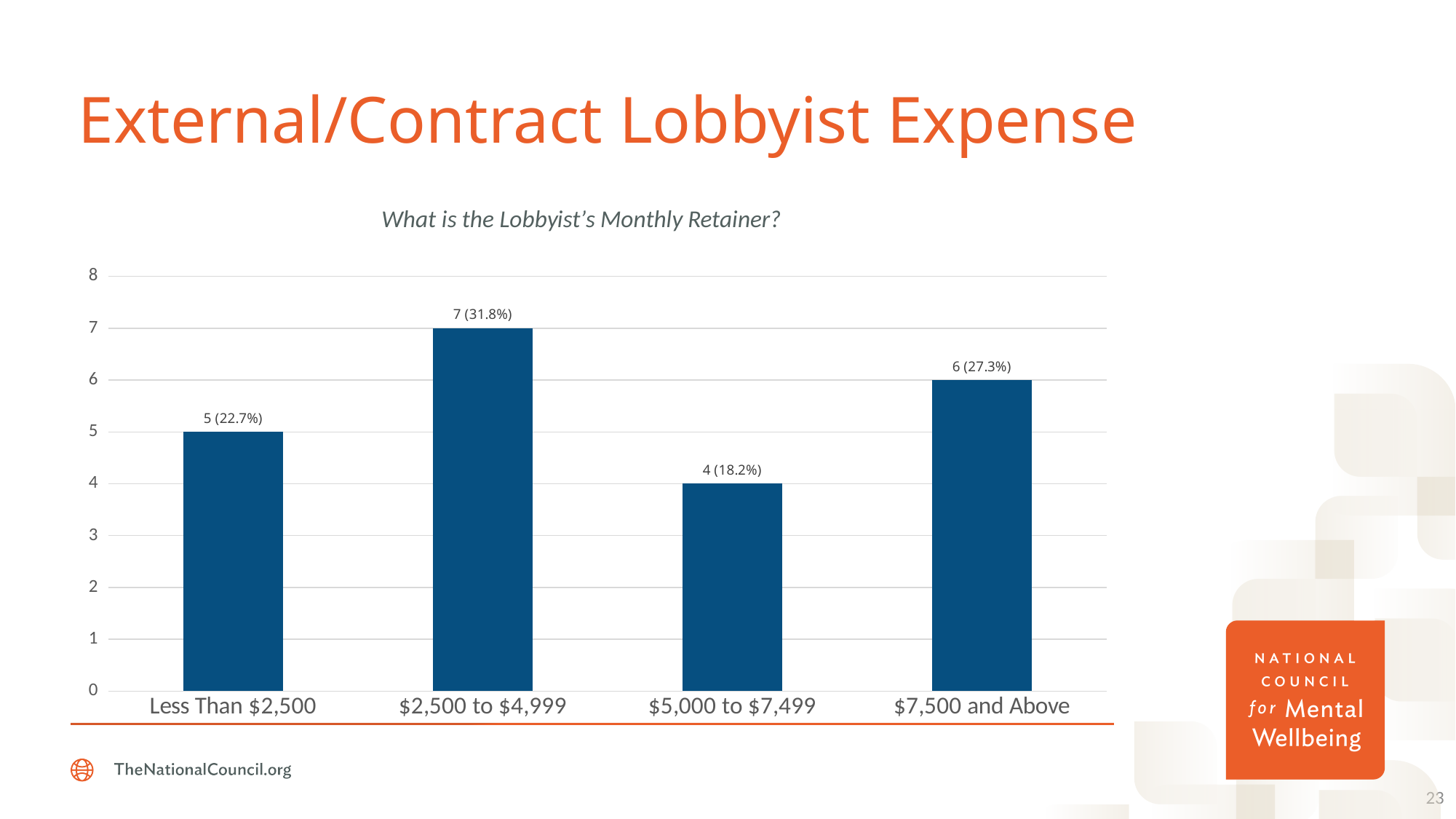
Which category has the highest value? $2,500 to $4,999 What question does the chart's subtitle ask? What is the Lobbyist's Monthly Retainer? What is the total count across all four categories? 22 What kind of chart is shown on the slide? bar chart Is the value for "$5,000 to $7,499" greater or less than 5? less What is the value for the "$7,500 and Above" category? 6 (27.3%) What is the value for the "$2,500 to $4,999" category? 7 (31.8%) What is the difference in count between "$2,500 to $4,999" and "$5,000 to $7,499"? 3 How many categories are shown on the x axis? 4 Which is larger, the value for "Less Than $2,500" or the value for "$7,500 and Above"? $7,500 and Above What is the value for the "Less Than $2,500" category? 5 (22.7%) Which category has the lowest value? $5,000 to $7,499